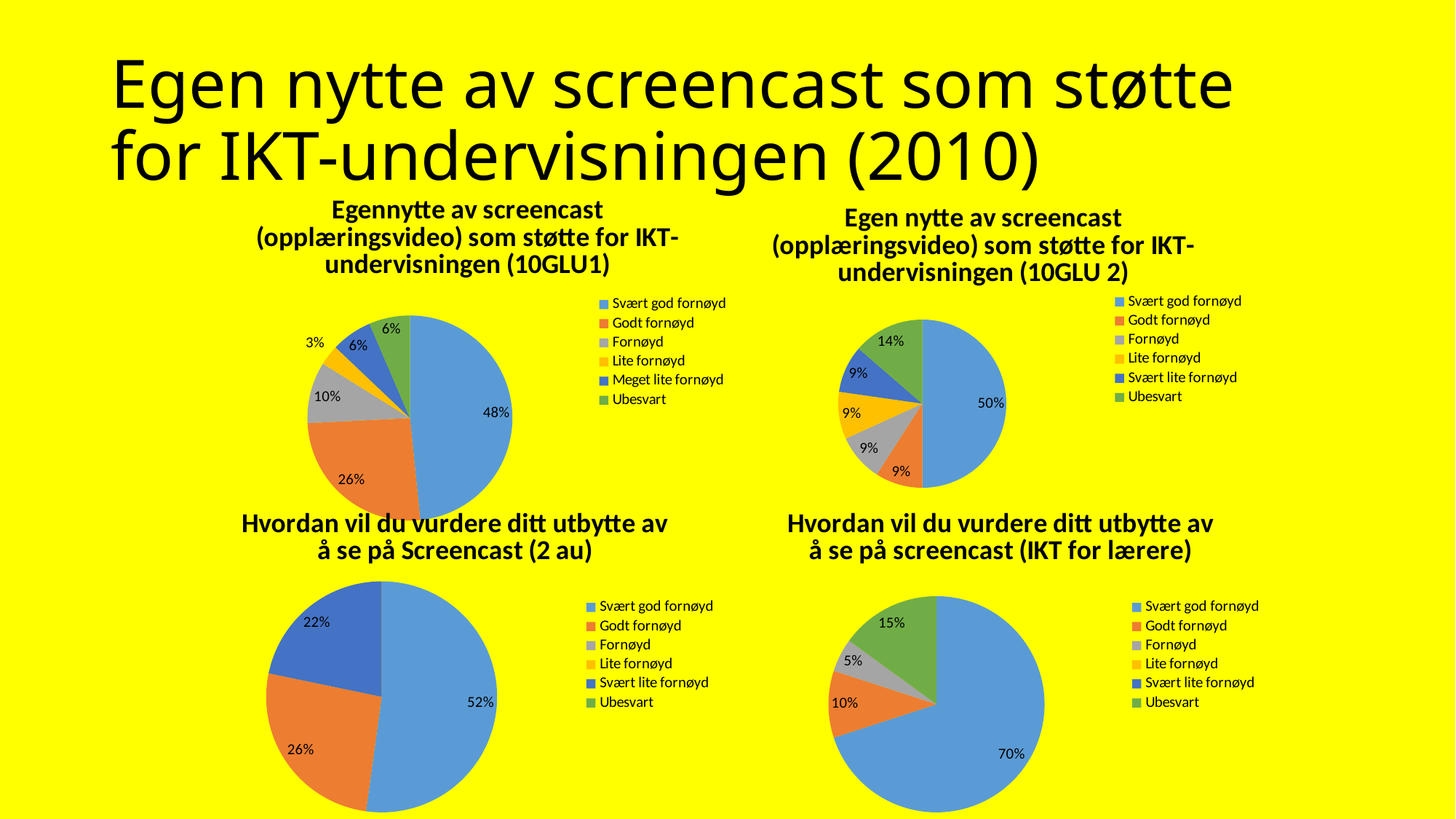
How many entries does the legend of the top-left pie chart (10GLU1) list? 6 In the top-right pie chart (10GLU 2), which category has the largest slice? Svært god fornøyd In the bottom-right pie chart (IKT for lærere), which category has the smallest labelled slice? Fornøyd In the top-right pie chart (10GLU 2), what share is labelled for Ubesvart? 14% In the bottom-right pie chart (IKT for lærere), what share is labelled for Svært god fornøyd? 70% In the top-left pie chart (10GLU1), what share is labelled for Godt fornøyd? 26% In the bottom-left pie chart (2 au), what share is labelled for Svært lite fornøyd? 22% In the bottom-right pie chart (IKT for lærere), which is larger: the Ubesvart slice or the Godt fornøyd slice? Ubesvart In the top-left pie chart (10GLU1), what share is labelled for Svært god fornøyd? 48% In the top-left pie chart (10GLU1), what share is labelled for Lite fornøyd? 3% In the bottom-left pie chart (2 au), what is the difference between the Svært god fornøyd slice and the Godt fornøyd slice? 26% What type of chart is used in the bottom-left chart (2 au)? Pie chart